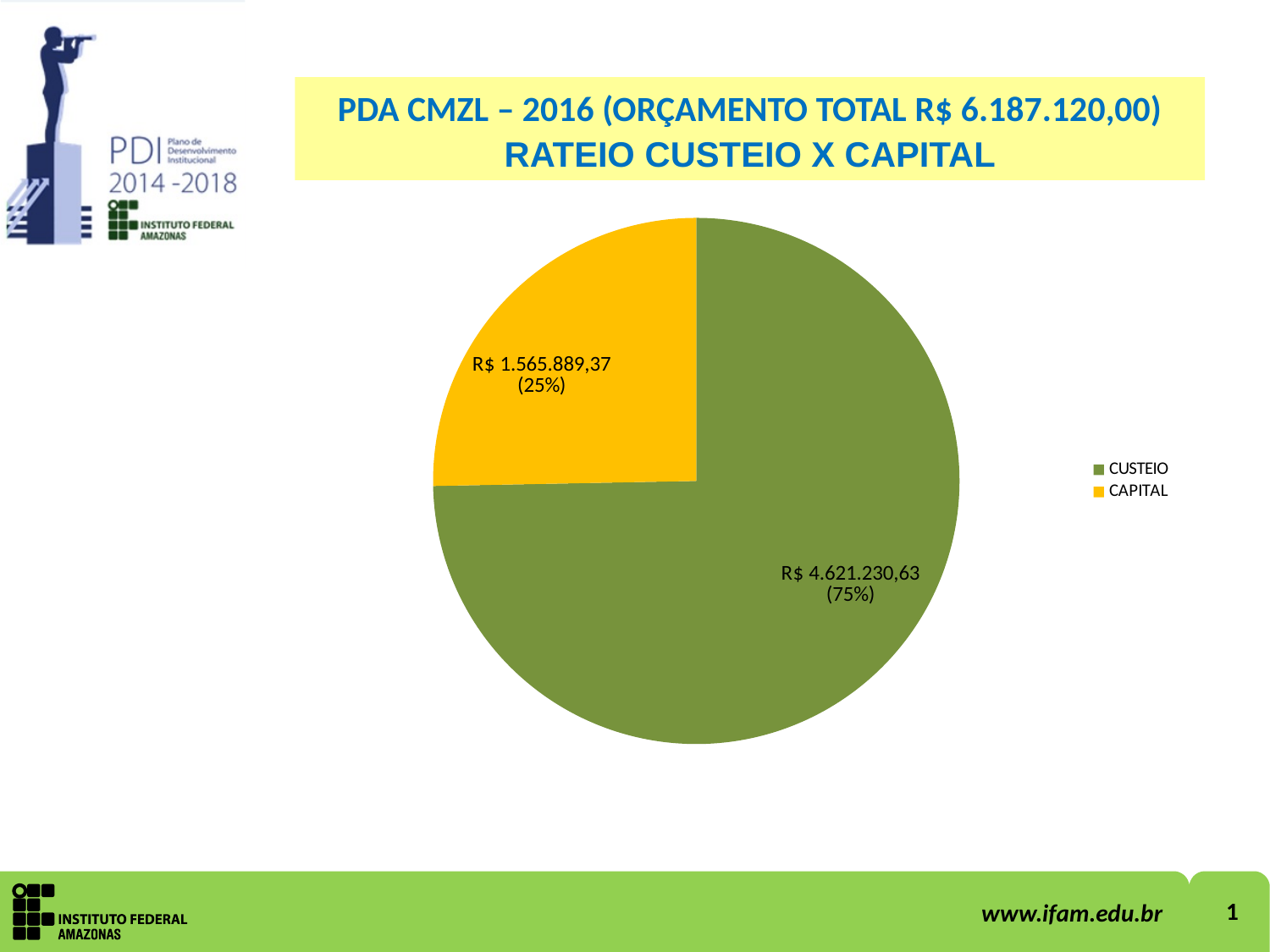
What share of the pie does CUSTEIO represent? 75% What is the value for CAPITAL? R$ 1.565.889,37 What total budget is stated in the chart title? R$ 6.187.120,00 What colour is the CAPITAL slice? yellow Which category has the largest slice? CUSTEIO What share of the pie does CAPITAL represent? 25% Which is larger, CUSTEIO or CAPITAL? CUSTEIO Which category has the smallest slice? CAPITAL How many entries does the legend list? 2 What type of chart is shown on the slide? pie chart How many categories does the pie chart have? 2 What is the value for CUSTEIO? R$ 4.621.230,63